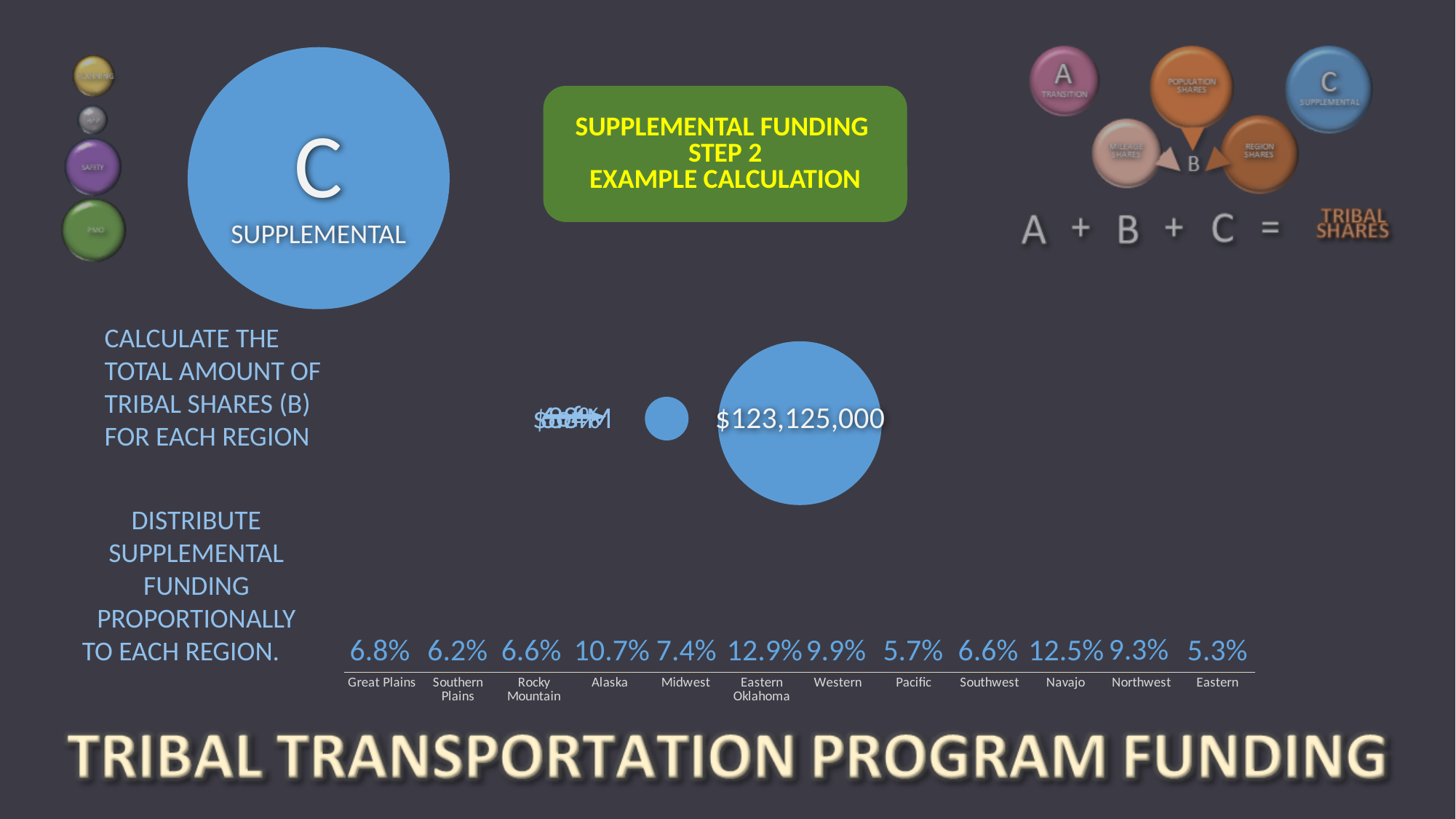
In the chart at the bottom of the slide, what is the difference between the values for Alaska and Midwest? 3.3% In the chart at the bottom of the slide, which two regions both have a value of 6.6%? Rocky Mountain and Southwest In the chart at the bottom of the slide, which is larger, the value for Western or the value for Northwest? Western In the chart at the bottom of the slide, which is larger, the value for Great Plains or the value for Southern Plains? Great Plains What is the value shown for Alaska in the chart at the bottom of the slide? 10.7% What is the value shown for Pacific in the chart at the bottom of the slide? 5.7% What is the value shown for Eastern Oklahoma in the chart at the bottom of the slide? 12.9% Which region has the highest value in the chart at the bottom of the slide? Eastern Oklahoma How many regions are shown in the chart at the bottom of the slide? 12 In the chart at the bottom of the slide, what is the difference between the values for Eastern Oklahoma and Navajo? 0.4% Which region has the lowest value in the chart at the bottom of the slide? Eastern What is the value shown for Navajo in the chart at the bottom of the slide? 12.5%